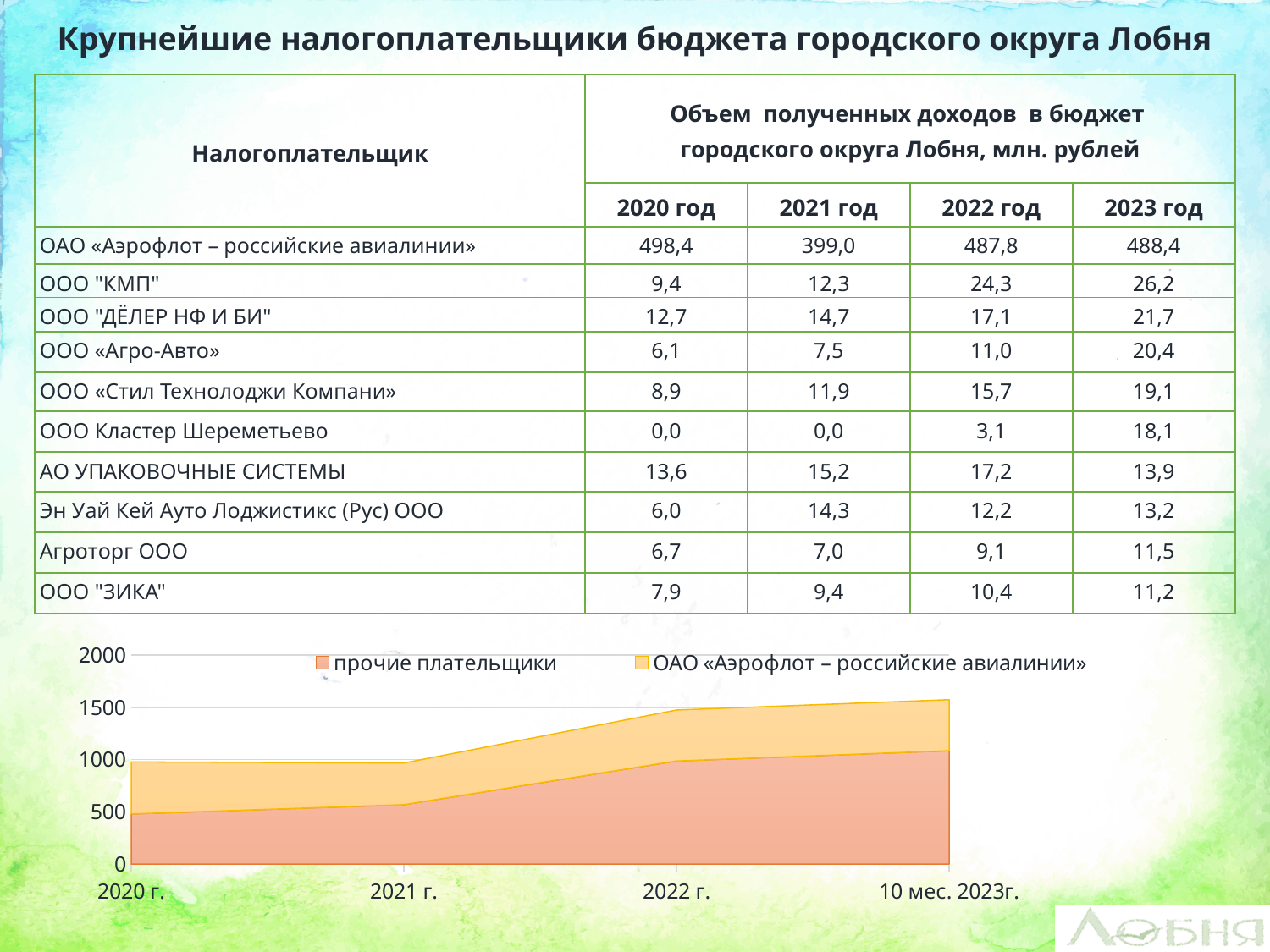
How many series does the legend of the chart list? 2 How many periods are shown along the x axis of the chart? 4 In which period is the total of the stacked areas the highest? 10 мес. 2023г. Which is larger for «прочие плательщики»: the value in 2020 г. or in 2022 г.? 2022 г. Does the value for «прочие плательщики» rise or fall from 2020 г. to 10 мес. 2023г.? rise Is the value for «прочие плательщики» in 2021 г. greater or less than 1000? less Is the total of the stacked areas in 10 мес. 2023г. greater or less than 1500? greater What kind of chart is shown at the bottom of the slide? area chart What is the last period labelled on the x axis of the chart? 10 мес. 2023г. In which period is the value for «прочие плательщики» the lowest? 2020 г. Which series is shown in the lower (salmon-coloured) area of the chart? прочие плательщики Is the value for «прочие плательщики» in 10 мес. 2023г. greater or less than 1000? greater